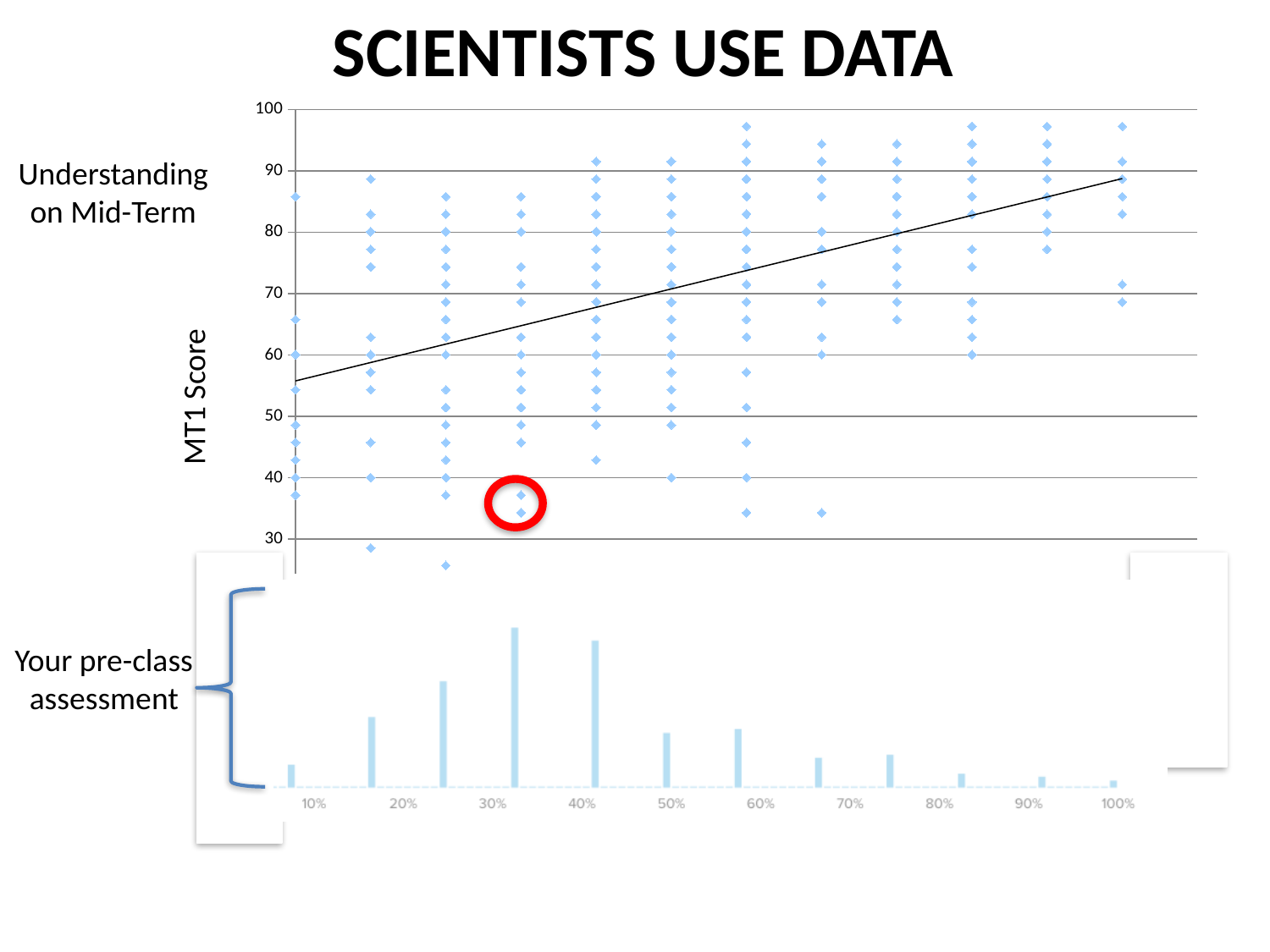
How many bars are plotted in the lower bar chart? 12 What is the label on the y axis of the upper scatter plot? MT1 Score In the upper scatter plot, are the circled points' MT1 scores greater or less than 40? less What is the highest percentage label shown on the x axis of the lower bar chart? 100% In the upper scatter plot, does the fitted trend line rise or fall as the x axis increases? rises In the upper scatter plot, is the lowest plotted point greater or less than 30? less In the lower bar chart, which bar is taller, the one near 25% or the one near 50%? the one near 25% What kind of chart is the upper chart on the slide? scatter plot In the lower bar chart, which bar is taller, the one near 42% or the one near 75%? the one near 42% What kind of chart is the lower chart on the slide? bar chart What is the highest tick value shown on the y axis of the upper scatter plot? 100